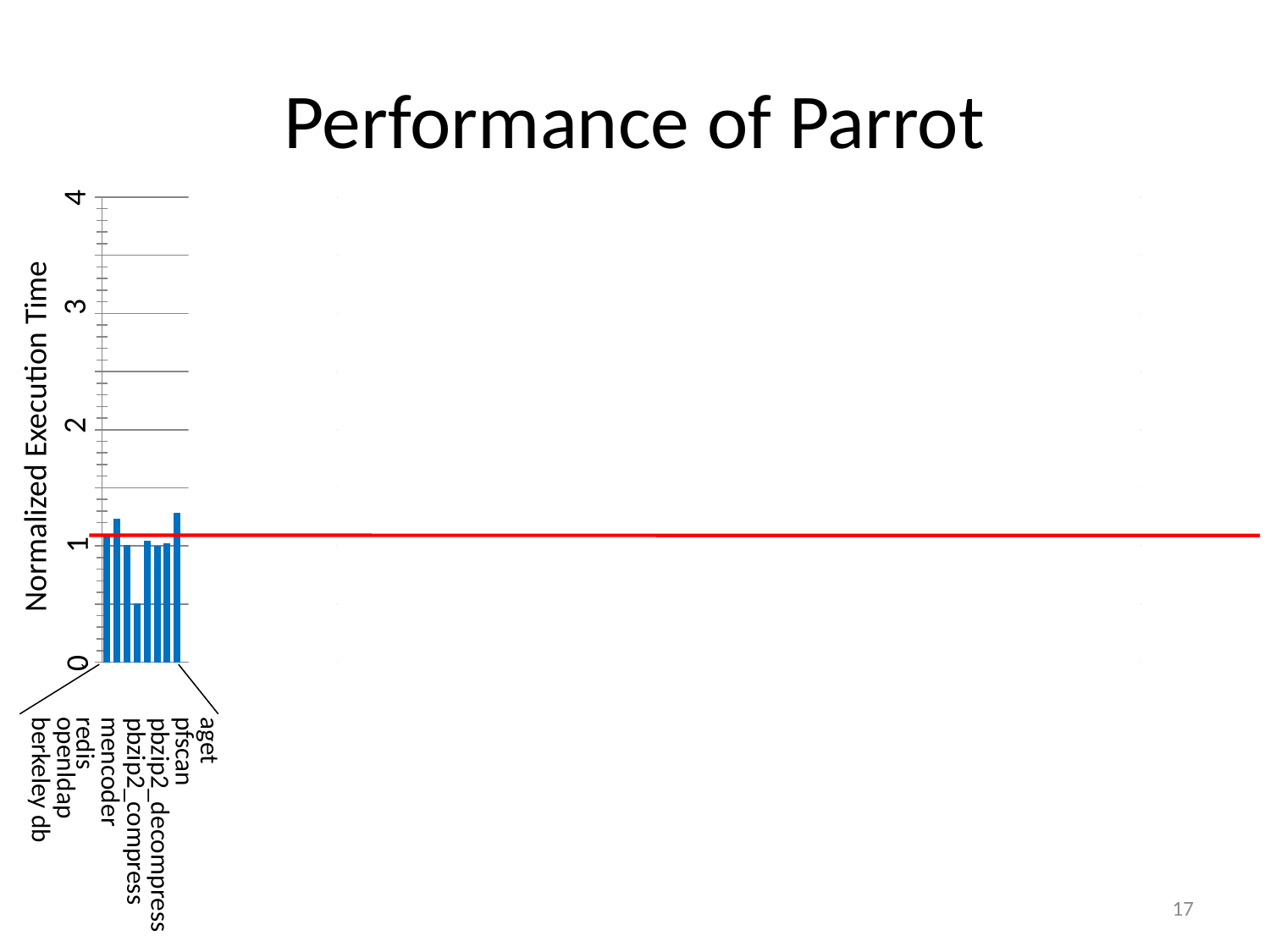
Is the tallest bar in the chart greater or less than 1? greater What is the title of the chart? Performance of Parrot Is the tallest bar in the chart greater or less than 2? less What is the label of the y axis? Normalized Execution Time How many category labels are listed along the x axis? 8 What kind of chart is shown on the slide? bar chart Is the shortest bar in the chart greater or less than 1? less What is the highest value shown on the y axis? 4